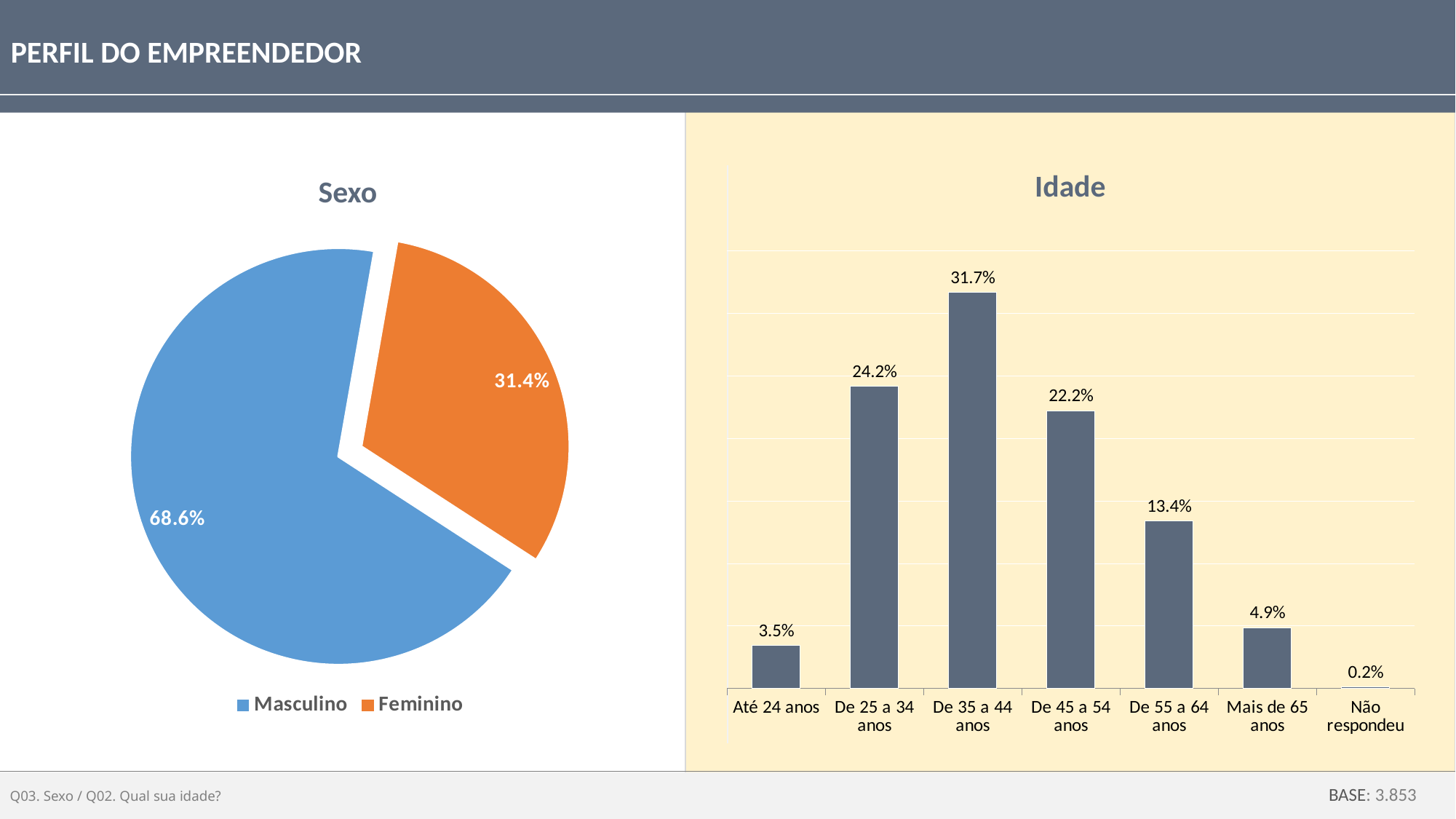
In the 'Idade' chart, which is larger: 'De 55 a 64 anos' or 'Até 24 anos'? De 55 a 64 anos In the 'Idade' chart, what is the value for 'De 35 a 44 anos'? 31.7% In the 'Sexo' pie chart, what share is Masculino? 68.6% In the 'Sexo' pie chart, what share is Feminino? 31.4% In the 'Idade' chart, what is the value for 'Mais de 65 anos'? 4.9% In the 'Sexo' chart, what kind of chart is shown? Pie chart In the 'Idade' chart, what kind of chart is shown? Bar chart In the 'Idade' chart, which category has the lowest value? Não respondeu In the 'Idade' chart, which category has the highest value? De 35 a 44 anos In the 'Idade' chart, what is the difference between 'De 25 a 34 anos' and 'De 45 a 54 anos'? 2.0% In the 'Sexo' chart, how many entries does the legend list? 2 In the 'Idade' chart, how many categories are shown on the x axis? 7